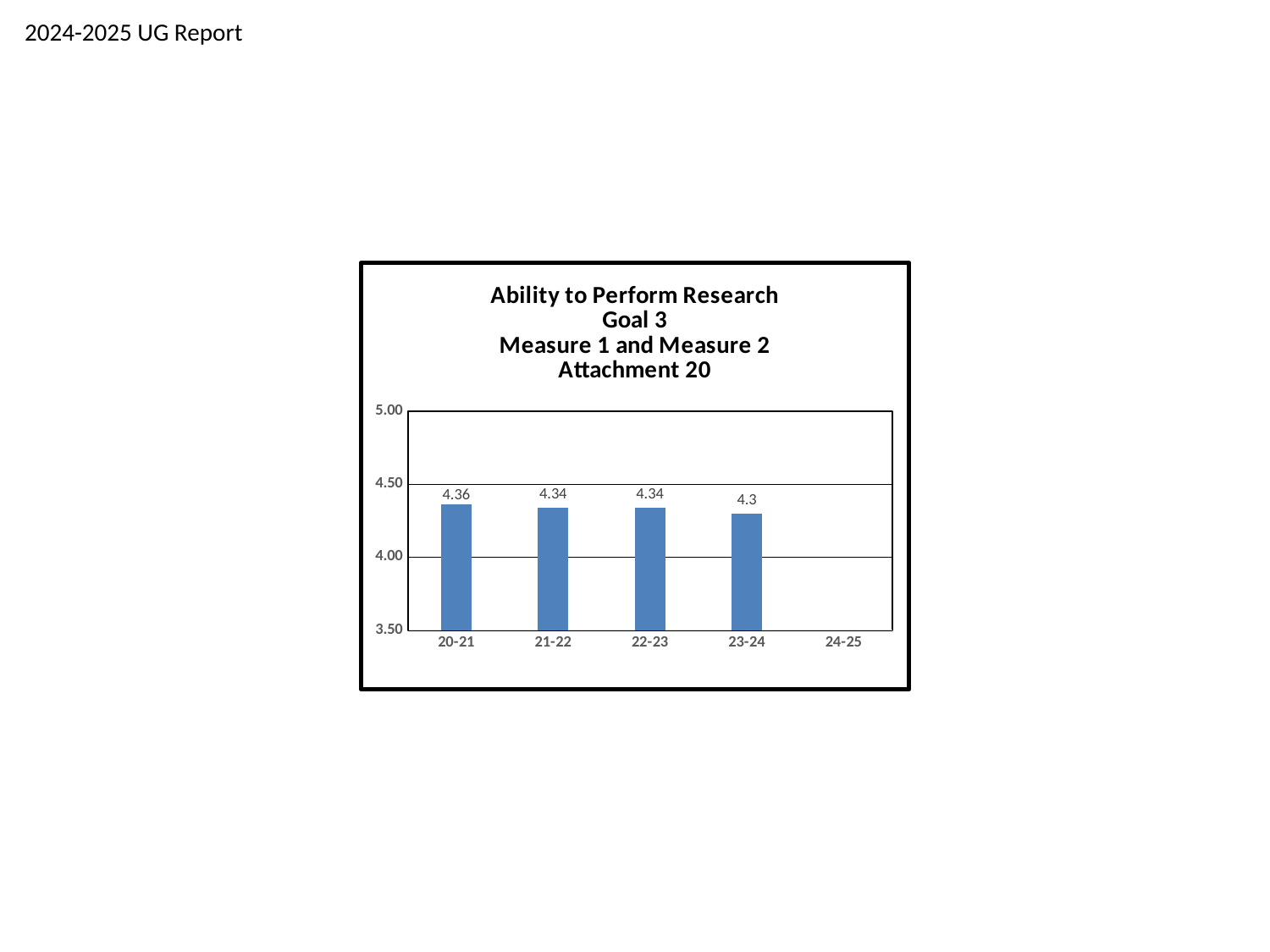
What kind of chart is shown? bar chart Which year category has no bar plotted? 24-25 What is the value for 22-23? 4.34 Is the value for 22-23 greater or less than 4.50? less What is the value for 20-21? 4.36 Do the values rise or fall from 20-21 to 23-24? fall Which year has the highest value? 20-21 Which is larger, the value for 21-22 or the value for 23-24? 21-22 How many year categories are shown on the x axis? 5 What is the value for 23-24? 4.3 What is the difference between the values for 20-21 and 23-24? 0.06 Which year with a plotted bar has the lowest value? 23-24